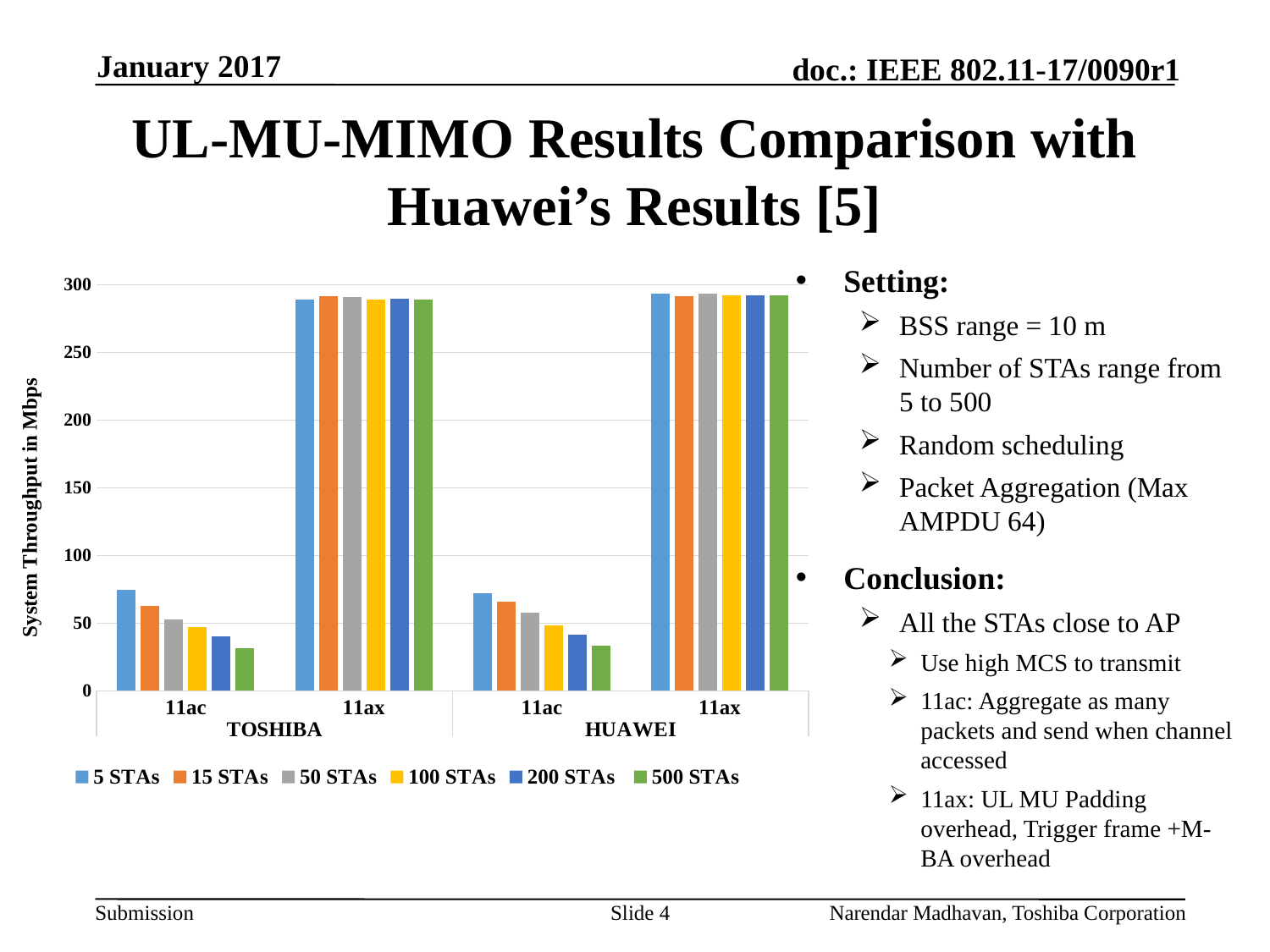
What kind of chart is shown on the slide? bar chart How many series does the chart legend list? 6 Is the value for 500 STAs under HUAWEI 11ac greater or less than 50? less Is the value for 500 STAs under TOSHIBA 11ac greater or less than 50? less Is the value for 200 STAs under HUAWEI 11ax greater or less than 250? greater Within the HUAWEI 11ac group, which series has the lowest value? 500 STAs Within the TOSHIBA 11ac group, which series has the highest value? 5 STAs Which two vendors are compared along the x axis of the chart? TOSHIBA and HUAWEI What is the label of the vertical axis of the chart? System Throughput in Mbps Within the TOSHIBA 11ac group, do the values rise or fall as the number of STAs increases from 5 to 500? fall